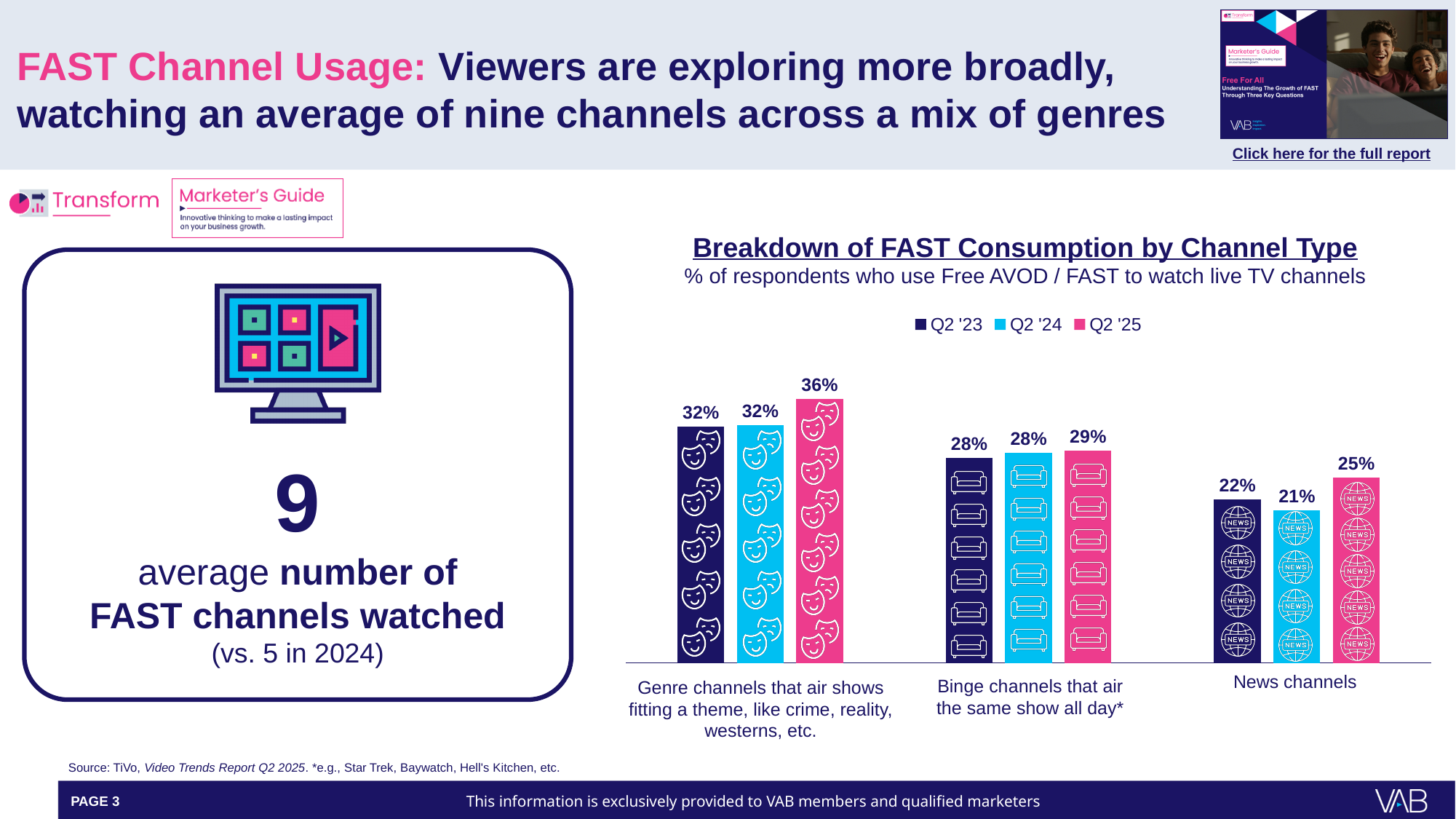
How many channel type categories are shown in the chart? 3 What is the Q2 '23 value for Binge channels? 28% Which is larger: the Q2 '25 value for Binge channels or the Q2 '25 value for News channels? Binge channels What is the difference between the Q2 '25 values for Genre channels and Binge channels? 7% Which channel type has the lowest Q2 '23 value? News channels What is the title of the chart? Breakdown of FAST Consumption by Channel Type How many series does the legend list? 3 What is the difference between the Q2 '25 and Q2 '24 values for News channels? 4% What is the Q2 '24 value for News channels? 21% What kind of chart is shown? Bar chart Which channel type has the highest Q2 '25 value? Genre channels What is the Q2 '25 value for Genre channels? 36%